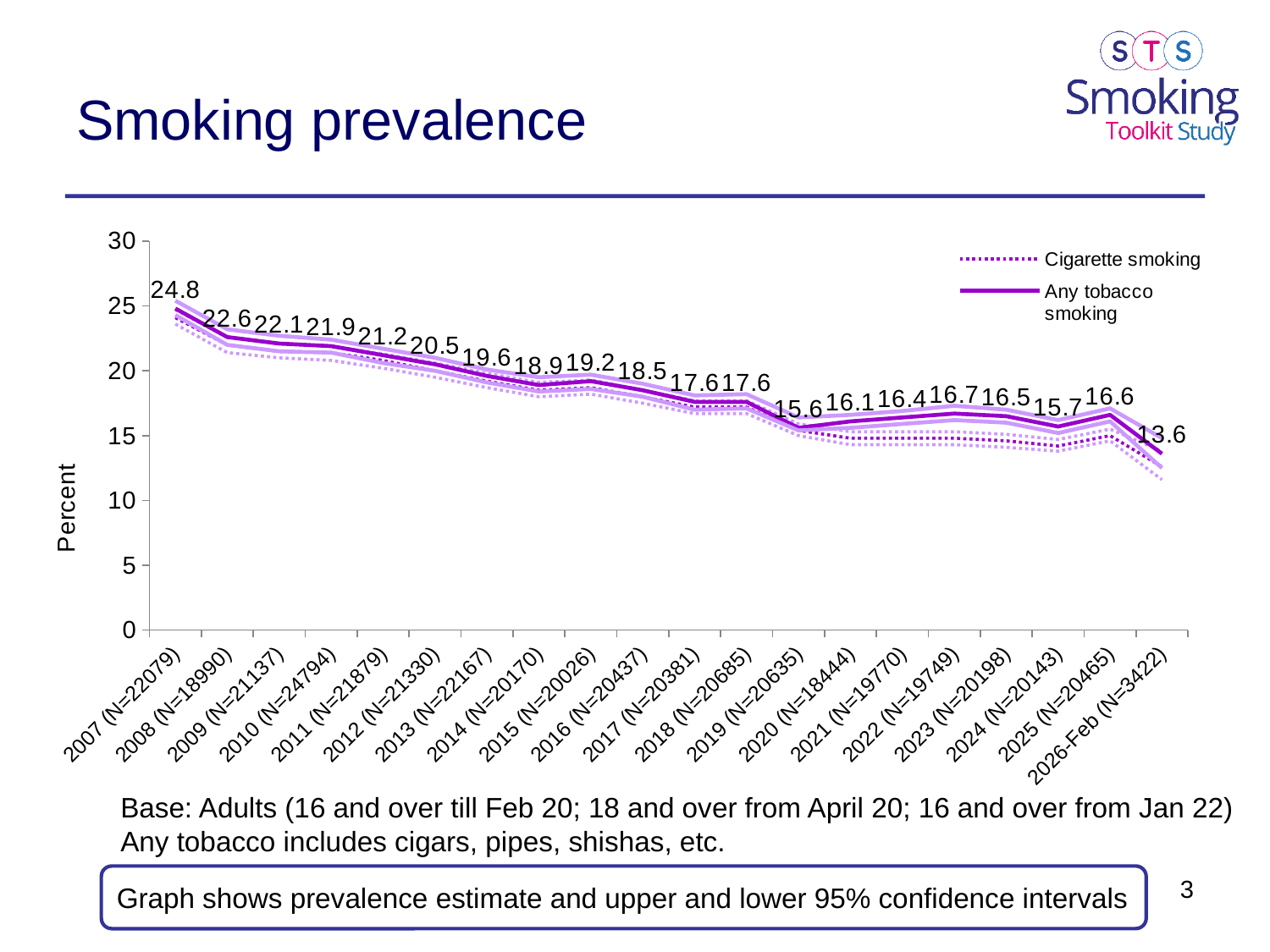
What is the any tobacco smoking prevalence for 2007 (N=22079)? 24.8 What is the any tobacco smoking prevalence for 2023 (N=20198)? 16.5 How many series does the legend list? 2 Which year has the lowest any tobacco smoking prevalence? 2026-Feb (N=3422) How many time points are plotted on the x axis? 20 What kind of chart is shown on the slide? Line chart What is the difference in any tobacco smoking prevalence between 2007 (N=22079) and 2026-Feb (N=3422)? 11.2 What is the any tobacco smoking prevalence for 2026-Feb (N=3422)? 13.6 What is the any tobacco smoking prevalence for 2019 (N=20635)? 15.6 Which is larger, the any tobacco smoking prevalence in 2015 (N=20026) or in 2014 (N=20170)? 2015 (N=20026) Which year has the highest any tobacco smoking prevalence? 2007 (N=22079) Overall, does any tobacco smoking prevalence rise or fall from 2007 to 2026-Feb? Fall